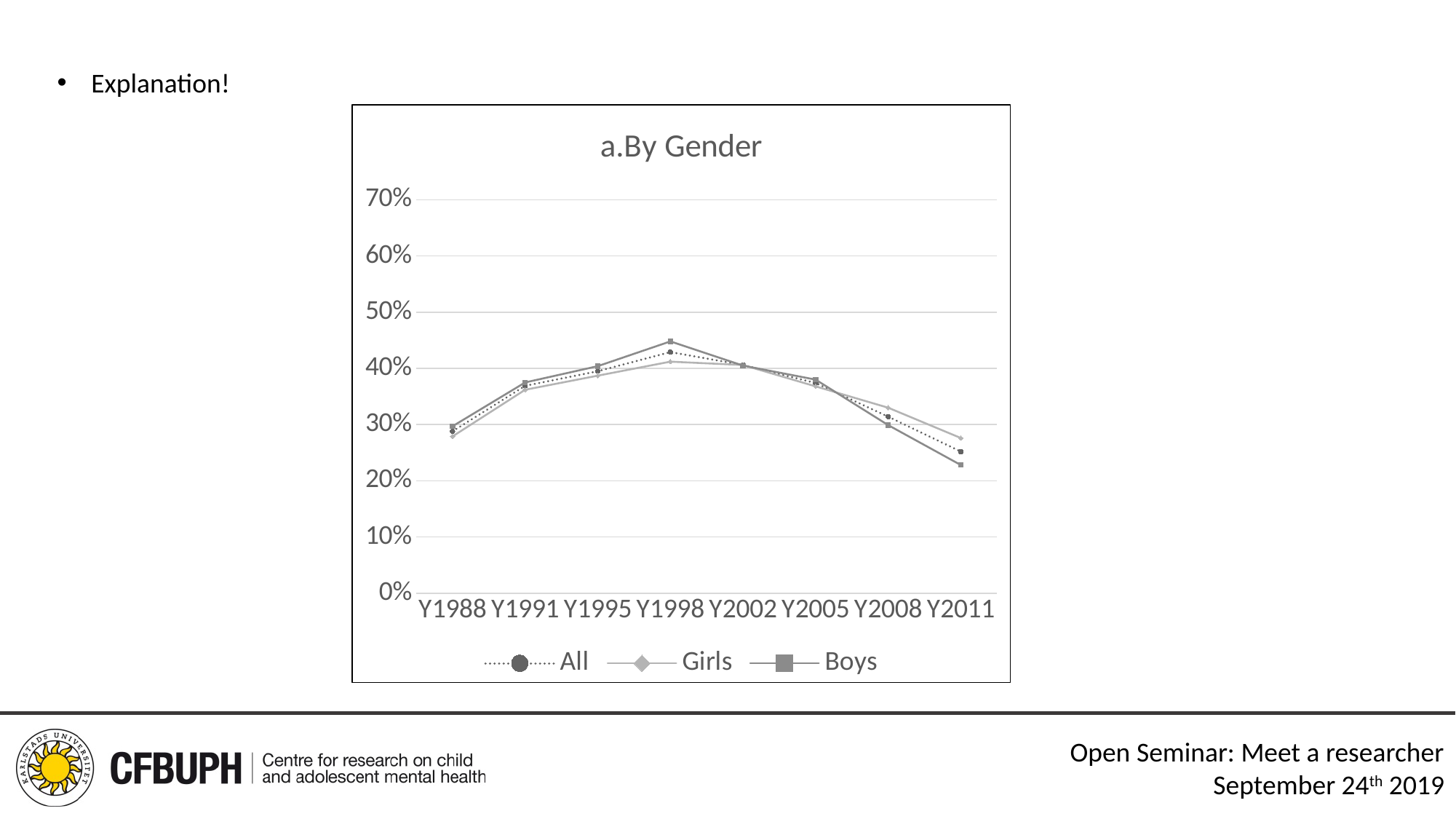
In which year does the All series reach its highest value? Y1998 Do the values for Boys rise or fall from Y1998 to Y2011? fall In Y2011, which is larger, the value for Girls or the value for Boys? Girls How many series does the legend list? 3 What kind of chart is shown on the slide? line chart In which year does the Boys series reach its lowest value? Y2011 How many years are shown on the x axis? 8 What is the title of the chart? a.By Gender In which year does the Boys series reach its highest value? Y1998 Is the value for Boys in Y2011 greater or less than 30%? less Is the value for Boys in Y1998 greater or less than 40%? greater Which series are listed in the legend? All, Girls, Boys